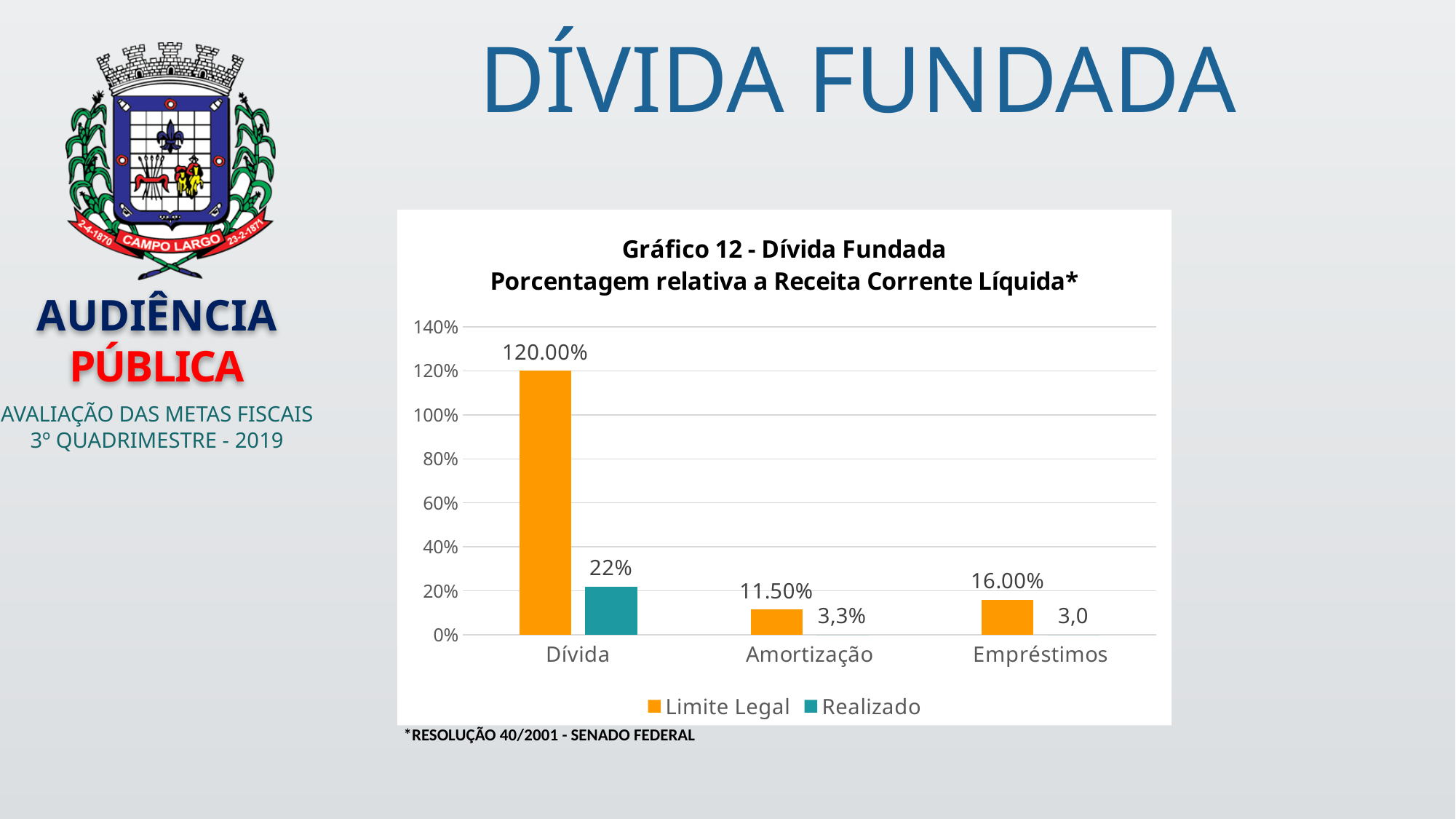
How many categories are shown on the x axis? 3 What kind of chart is shown on the slide? Bar chart What is the difference between the Limite Legal values for Dívida and Empréstimos? 104.00% What is the Realizado value labelled for Amortização? 3,3% Which category has the lowest Limite Legal value? Amortização What is the Realizado value for Dívida? 22% What is the Limite Legal value for Dívida? 120.00% What is the Limite Legal value for Empréstimos? 16.00% Which category has the highest Limite Legal value? Dívida How many series does the legend list? 2 What is the Limite Legal value for Amortização? 11.50% Which is larger, the Limite Legal value for Amortização or for Empréstimos? Empréstimos